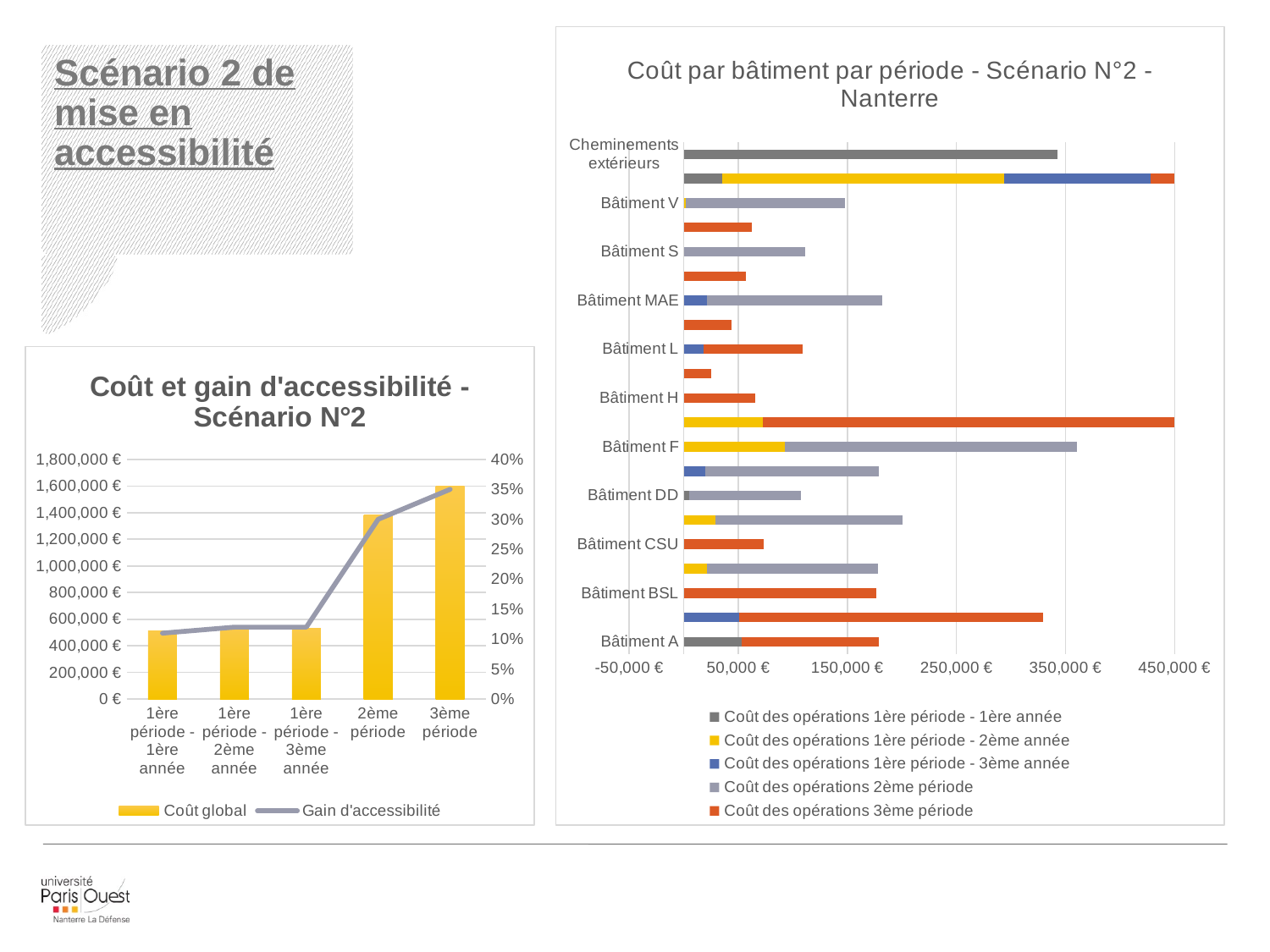
In the 'Coût par bâtiment par période - Scénario N°2 - Nanterre' chart, is the 'Coût des opérations 2ème période' value for Bâtiment V greater or less than 250,000 €? less In the 'Coût et gain d'accessibilité - Scénario N°2' chart, which is larger: the 'Coût global' for '2ème période' or for '1ère période - 3ème année'? 2ème période In the 'Coût et gain d'accessibilité - Scénario N°2' chart, which category has the highest 'Coût global'? 3ème période How many series does the legend of the 'Coût par bâtiment par période - Scénario N°2 - Nanterre' chart list? 5 In the 'Coût et gain d'accessibilité - Scénario N°2' chart, is the 'Coût global' for '2ème période' greater or less than 1,000,000 €? greater How many series does the legend of the 'Coût et gain d'accessibilité - Scénario N°2' chart list? 2 In the 'Coût et gain d'accessibilité - Scénario N°2' chart, does the 'Gain d'accessibilité' line rise or fall from the first category to the last? Rises In the 'Coût par bâtiment par période - Scénario N°2 - Nanterre' chart, which colour represents 'Coût des opérations 3ème période'? Orange/red What type of chart is the 'Coût par bâtiment par période - Scénario N°2 - Nanterre' chart? Bar chart In the 'Coût par bâtiment par période - Scénario N°2 - Nanterre' chart, is the 'Coût des opérations 3ème période' value for Bâtiment H greater or less than 350,000 €? less How many categories are on the x axis of the 'Coût et gain d'accessibilité - Scénario N°2' chart? 5